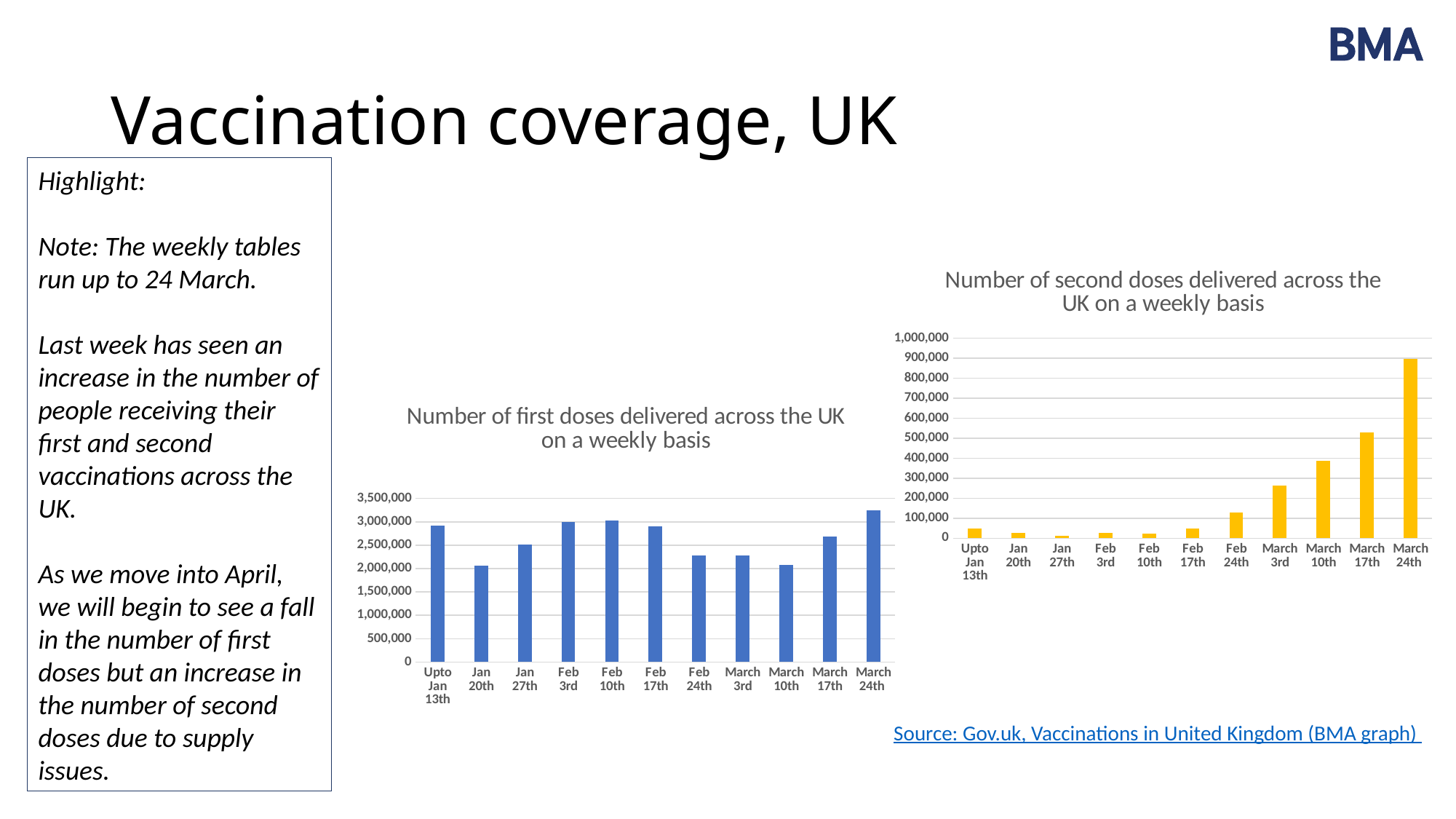
In the "Number of second doses delivered across the UK on a weekly basis" chart, is the value for March 3rd greater or less than 200,000? greater What kind of chart is "Number of first doses delivered across the UK on a weekly basis"? bar chart In the "Number of second doses delivered across the UK on a weekly basis" chart, which week has the lowest value? Jan 27th In the "Number of first doses delivered across the UK on a weekly basis" chart, which is larger, the value for Feb 3rd or the value for Feb 24th? Feb 3rd In the "Number of second doses delivered across the UK on a weekly basis" chart, do the values generally rise or fall from Feb 17th to March 24th? rise How many weeks are plotted in the "Number of first doses delivered across the UK on a weekly basis" chart? 11 In the "Number of second doses delivered across the UK on a weekly basis" chart, is the value for March 24th greater or less than 800,000? greater In the "Number of first doses delivered across the UK on a weekly basis" chart, is the value for Jan 20th greater or less than 2,500,000? less In the "Number of second doses delivered across the UK on a weekly basis" chart, which week has the highest value? March 24th What colour are the bars in the "Number of second doses delivered across the UK on a weekly basis" chart? yellow In the "Number of first doses delivered across the UK on a weekly basis" chart, which week has the highest value? March 24th